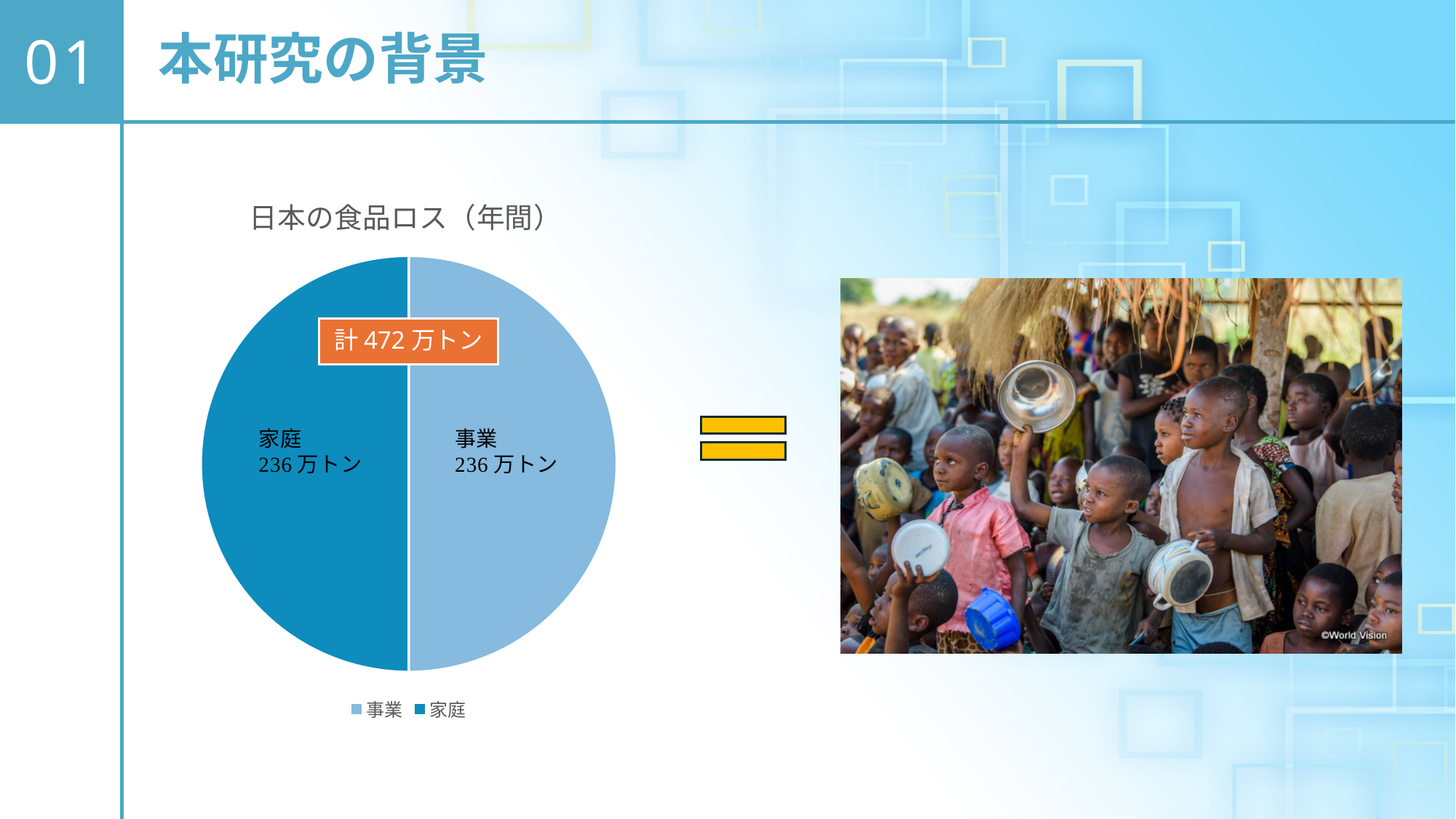
What type of chart is shown on the slide? pie chart Which legend entry is shown in the darker blue colour? 家庭 What is the difference between the values for 家庭 and 事業? 0 万トン What is the title of the chart? 日本の食品ロス（年間） What share of the pie does 事業 represent? 50% What share of the pie does 家庭 represent? 50% What is the value for 事業 in the pie chart? 236 万トン What is the value for 家庭 in the pie chart? 236 万トン What is the total shown in the centre of the pie chart? 計 472 万トン How many slices does the pie chart have? 2 How many entries does the legend list? 2